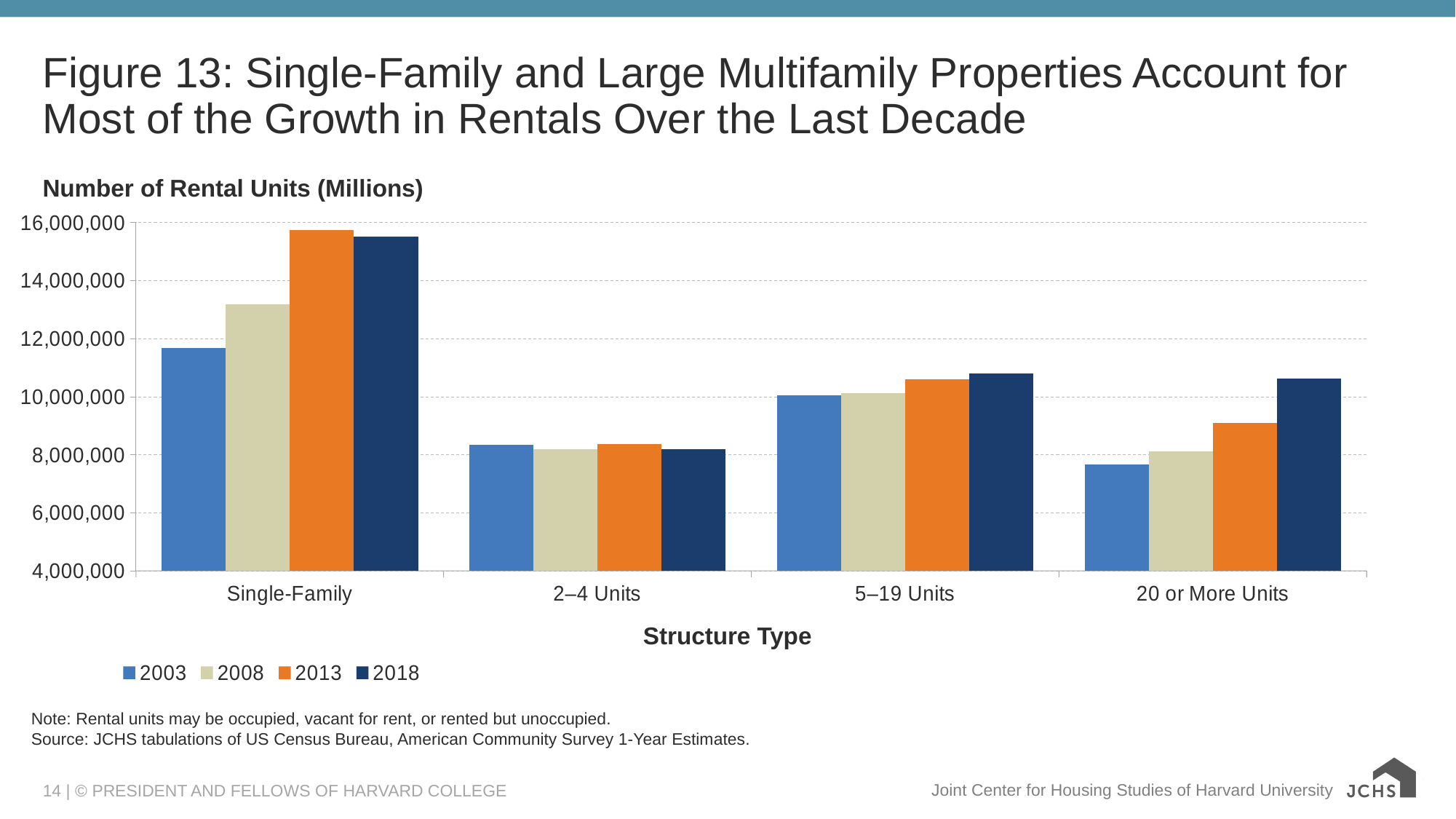
For Single-Family, which year has the larger value, 2013 or 2018? 2013 What is the title of the vertical axis? Number of Rental Units (Millions) Is the value for Single-Family in 2003 greater or less than 12,000,000? less Which structure type has the lowest number of rental units in 2003? 20 or More Units Is the value for 20 or More Units in 2018 greater or less than 10,000,000? greater Which structure type has the highest number of rental units in 2018? Single-Family What kind of chart is shown on the slide? Bar chart Is the value for 2–4 Units in 2013 greater or less than 10,000,000? less In 2003, which has more rental units, 2–4 Units or 5–19 Units? 5–19 Units For 20 or More Units, do the values rise or fall from 2003 to 2018? rise How many structure type categories are shown on the x axis? 4 How many series does the legend list? 4